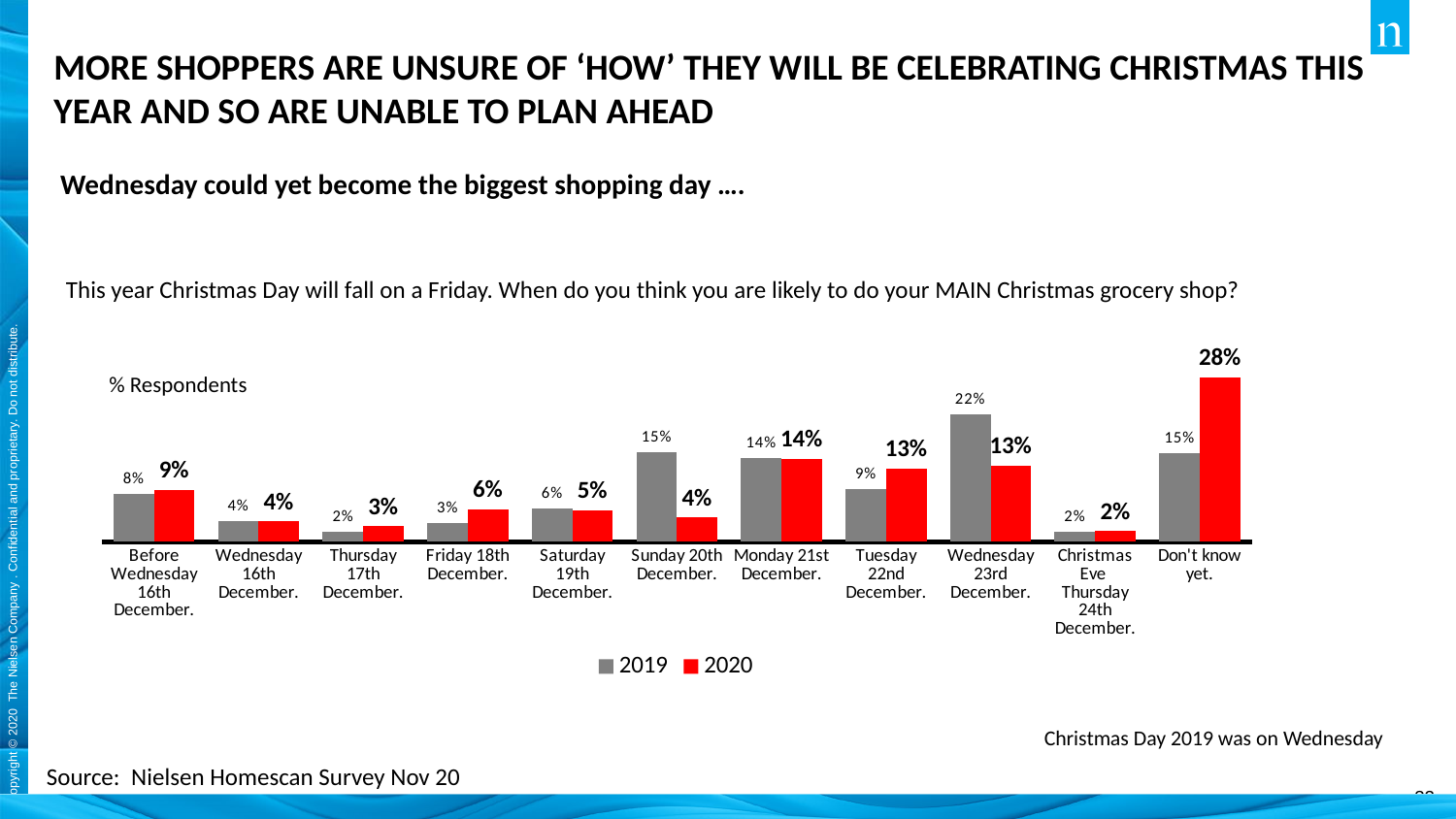
What is the difference between the 2019 and 2020 values for Wednesday 23rd December? 9 percentage points What type of chart is shown on the slide? Bar chart Which category has the lowest value for the 2020 series? Christmas Eve Thursday 24th December. What percentage of respondents in 2020 said they don't know yet when they will do their main Christmas grocery shop? 28% What is the 2020 value for Friday 18th December? 6% Which category has the highest value for the 2019 series? Wednesday 23rd December. Which category has the highest value for the 2020 series? Don't know yet. For Sunday 20th December, which series has the larger value, 2019 or 2020? 2019 How many categories are shown on the x axis of the chart? 11 What colour represents the 2020 series in the chart? Red What was the 2019 value for Wednesday 23rd December? 22% How many series does the legend list? 2